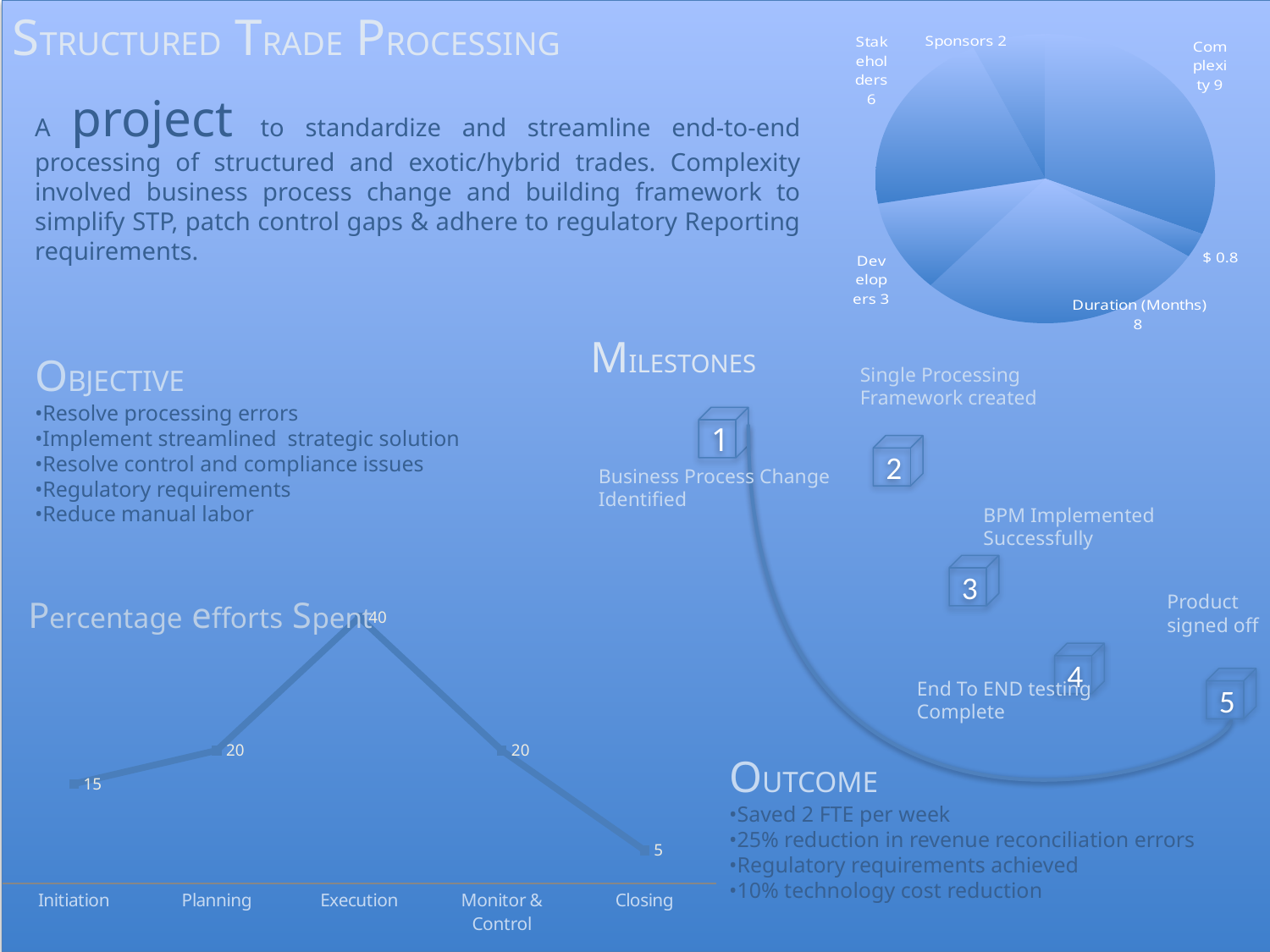
In the 'Percentage efforts Spent' chart, what is the value for Execution? 40 In the 'Percentage efforts Spent' chart, which is larger, the value for Initiation or the value for Monitor & Control? Monitor & Control In the 'Percentage efforts Spent' chart, which phase has the lowest value? Closing In the pie chart at the top right, what is the value shown for Duration (Months)? 8 In the 'Percentage efforts Spent' chart, what is the value for Initiation? 15 In the 'Percentage efforts Spent' chart, what is the value for Closing? 5 How many phases are plotted in the 'Percentage efforts Spent' chart? 5 In the 'Percentage efforts Spent' chart, which phase has the highest value? Execution In the pie chart at the top right, what is the value shown for Complexity? 9 What kind of chart is the 'Percentage efforts Spent' chart? Line chart In the 'Percentage efforts Spent' chart, what is the difference between the values for Execution and Planning? 20 In the 'Percentage efforts Spent' chart, do the values rise or fall from Execution to Closing? Fall